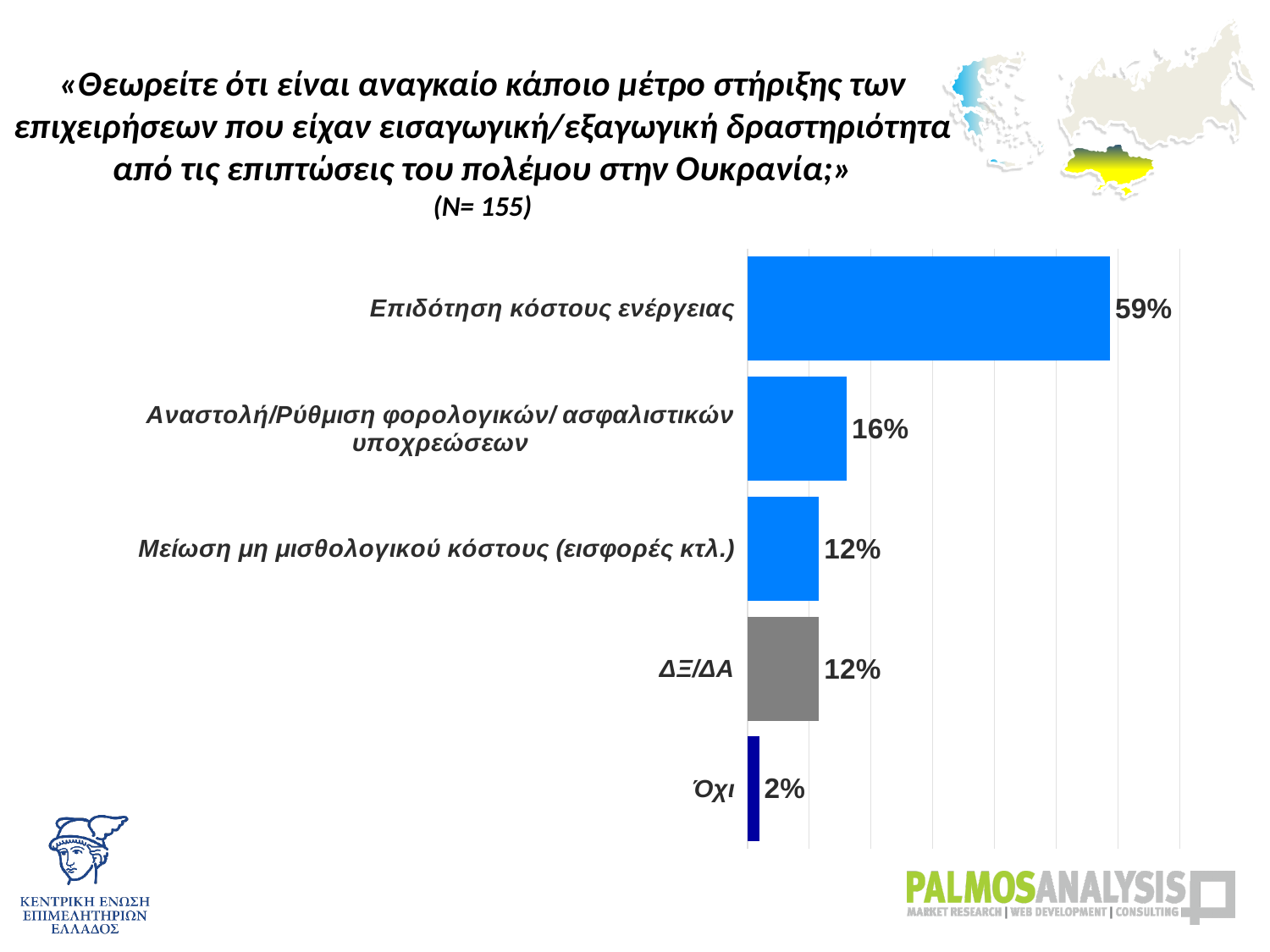
What is the value for Όχι? 2% What is the value for Επιδότηση κόστους ενέργειας? 59% Which is larger, the value for Αναστολή/Ρύθμιση φορολογικών/ ασφαλιστικών υποχρεώσεων or the value for Όχι? Αναστολή/Ρύθμιση φορολογικών/ ασφαλιστικών υποχρεώσεων What kind of chart is shown on the slide? Bar chart What is the difference between the values for Επιδότηση κόστους ενέργειας and Αναστολή/Ρύθμιση φορολογικών/ ασφαλιστικών υποχρεώσεων? 43% Which category has the lowest value? Όχι How many categories are shown in the chart? 5 What is the value for ΔΞ/ΔΑ? 12% What is the value for Αναστολή/Ρύθμιση φορολογικών/ ασφαλιστικών υποχρεώσεων? 16% What is the sample size (N) stated under the chart title? 155 Which category has the highest value? Επιδότηση κόστους ενέργειας What is the value for Μείωση μη μισθολογικού κόστους (εισφορές κτλ.)? 12%